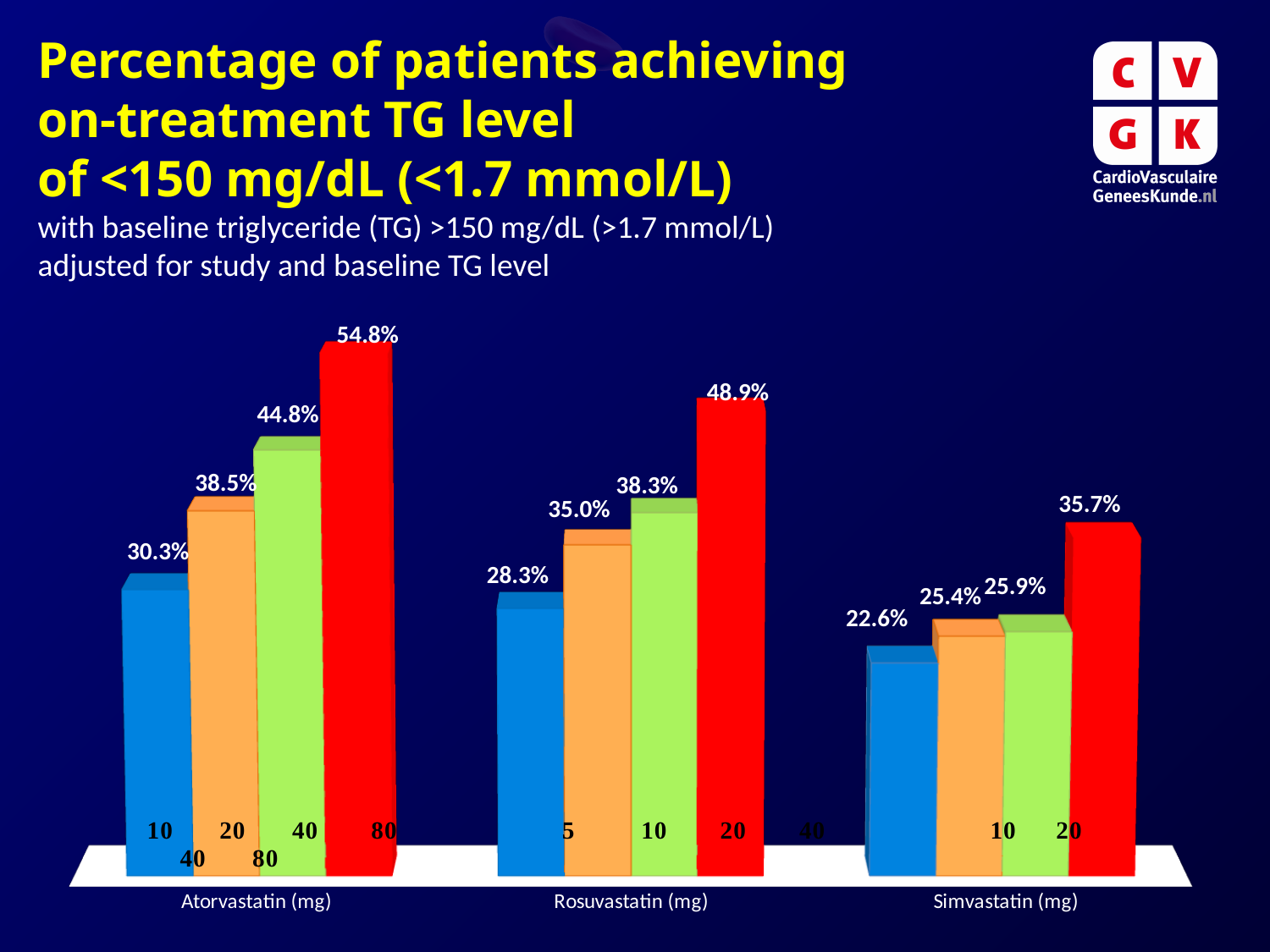
What is the value of the red (fourth) bar in the Atorvastatin (mg) group? 54.8% Which bar on the chart has the highest value? The red bar in the Atorvastatin (mg) group (54.8%) What is the value of the orange (second) bar in the Rosuvastatin (mg) group? 35.0% Within the Rosuvastatin (mg) group, do the values rise or fall from the first bar to the fourth bar? rise Which is larger: the green bar in the Atorvastatin (mg) group or the red bar in the Simvastatin (mg) group? The green bar in the Atorvastatin (mg) group (44.8%) What is the value of the blue (first) bar in the Rosuvastatin (mg) group? 28.3% What is the difference between the red bar and the blue bar in the Atorvastatin (mg) group? 24.5% What is the value of the green (third) bar in the Simvastatin (mg) group? 25.9% How many drug groups are shown along the x axis of the chart? 3 Which bar on the chart has the lowest value? The blue bar in the Simvastatin (mg) group (22.6%) What type of chart is shown on the slide? bar chart What is the difference between the red bar in the Rosuvastatin (mg) group and the red bar in the Simvastatin (mg) group? 13.2%